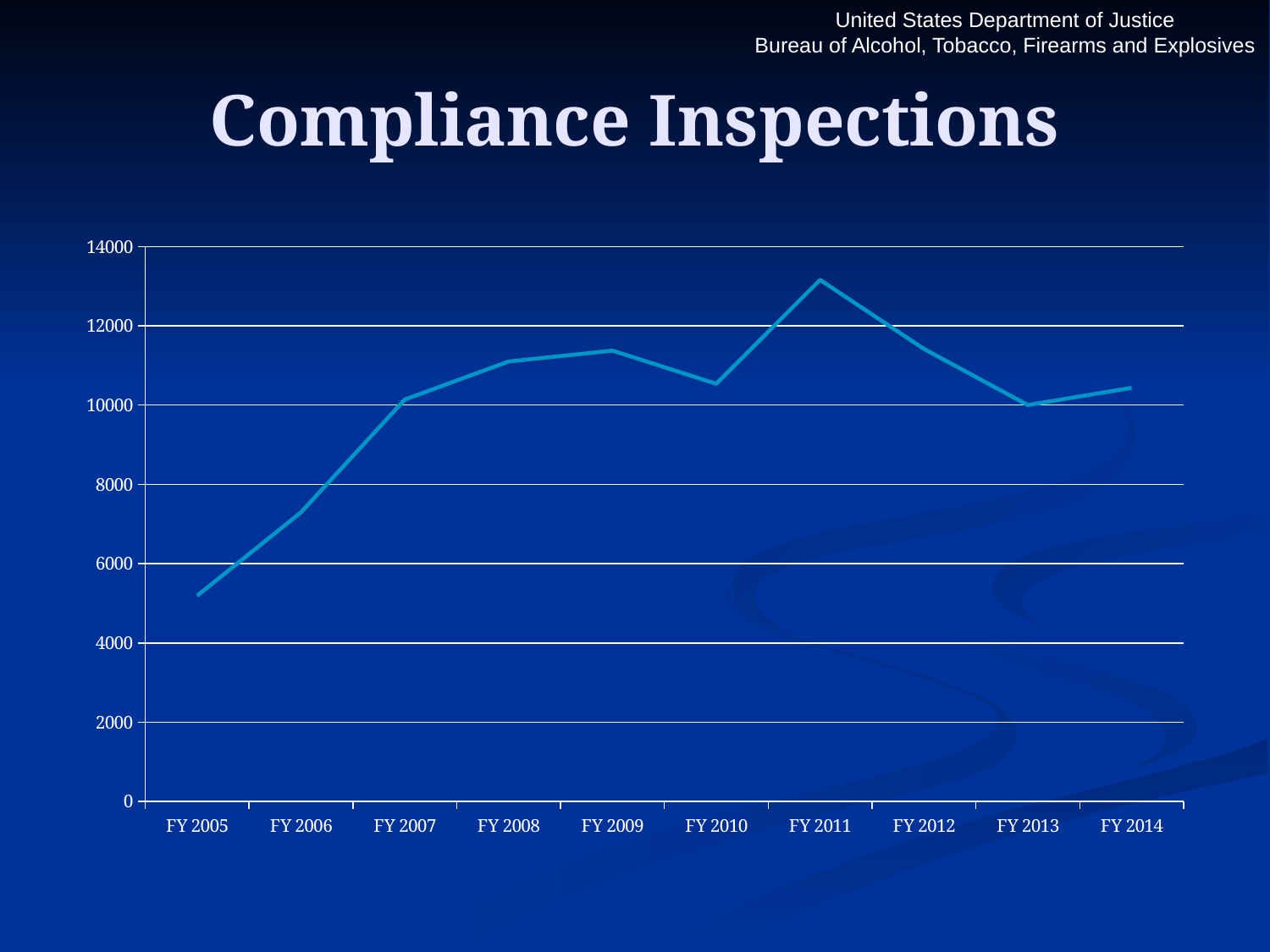
Is the value for FY 2009 greater or less than 10000? greater What is the title of the chart? Compliance Inspections Which fiscal year has the lowest number of compliance inspections? FY 2005 Is the value for FY 2011 greater or less than 12000? greater Is the value for FY 2005 greater or less than 6000? less Which is larger, the value for FY 2011 or the value for FY 2012? FY 2011 Do the values rise or fall from FY 2005 to FY 2007? rise What kind of chart is shown on the slide? line chart Which is larger, the value for FY 2007 or the value for FY 2006? FY 2007 How many fiscal years are plotted on the x axis? 10 Which fiscal year has the highest number of compliance inspections? FY 2011